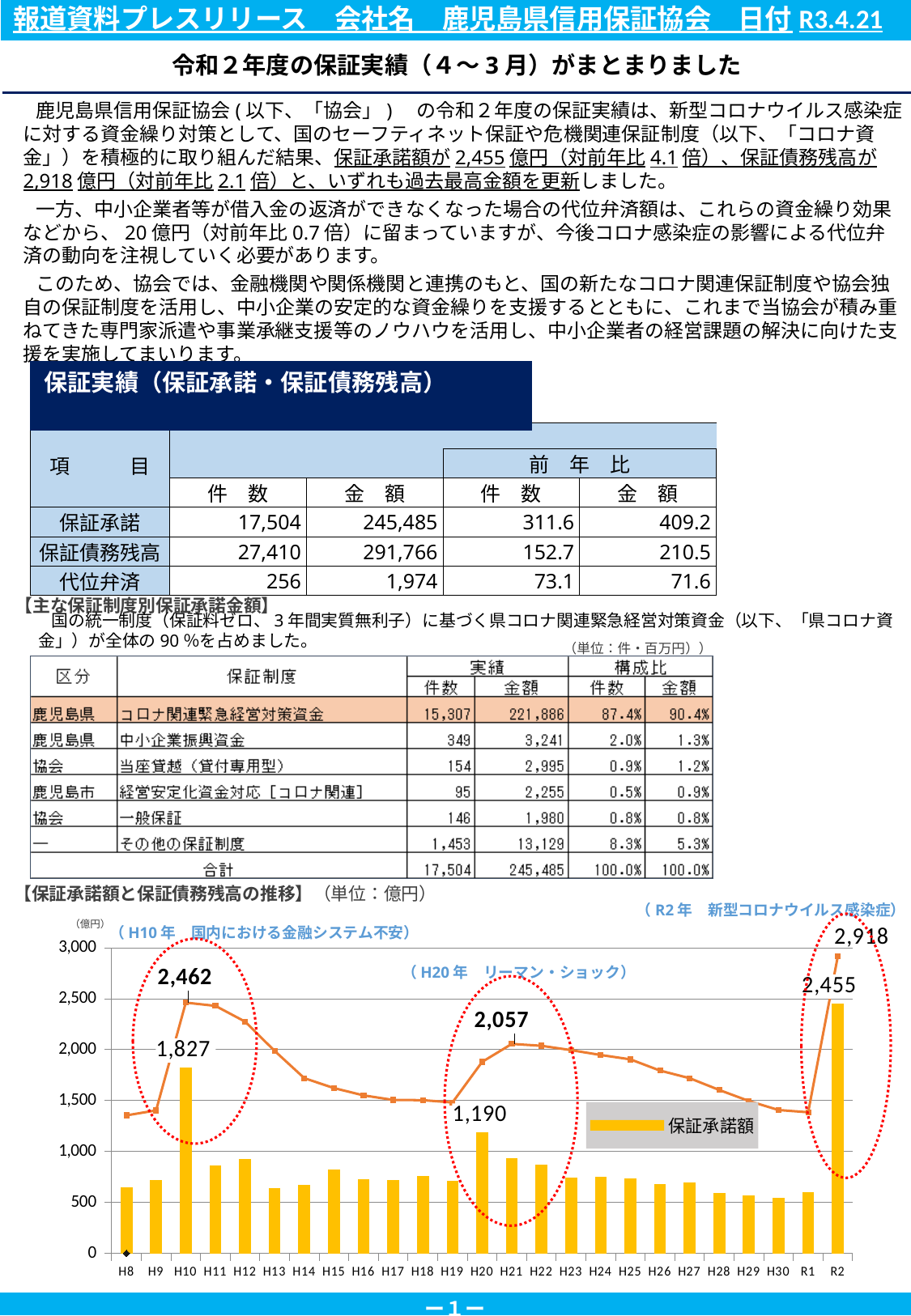
In the 保証承諾額と保証債務残高の推移 chart, what is the 保証承諾額 value labelled for H10? 1,827 In the 保証承諾額と保証債務残高の推移 chart, what is the 保証承諾額 value labelled for R2? 2,455 How many series does the legend of the 保証承諾額と保証債務残高の推移 chart list? 1 In the 保証承諾額と保証債務残高の推移 chart, what is the difference between the 保証承諾額 for R2 and for H10? 628 In the 保証承諾額と保証債務残高の推移 chart, is the 保証承諾額 bar for H8 greater or less than 1,000? less In the 保証承諾額と保証債務残高の推移 chart, which year has the highest 保証承諾額 bar? R2 How many years are shown on the x axis of the 保証承諾額と保証債務残高の推移 chart? 25 In the 保証承諾額と保証債務残高の推移 chart, what value is labelled on the line at R2? 2,918 In the 保証承諾額と保証債務残高の推移 chart, which is larger, the 保証承諾額 bar for H10 or for H20? H10 In the 保証承諾額と保証債務残高の推移 chart, what is the 保証承諾額 value labelled for H20? 1,190 In the 保証承諾額と保証債務残高の推移 chart, what value is labelled on the line at H21? 2,057 What unit is stated for the 保証承諾額と保証債務残高の推移 chart? 億円